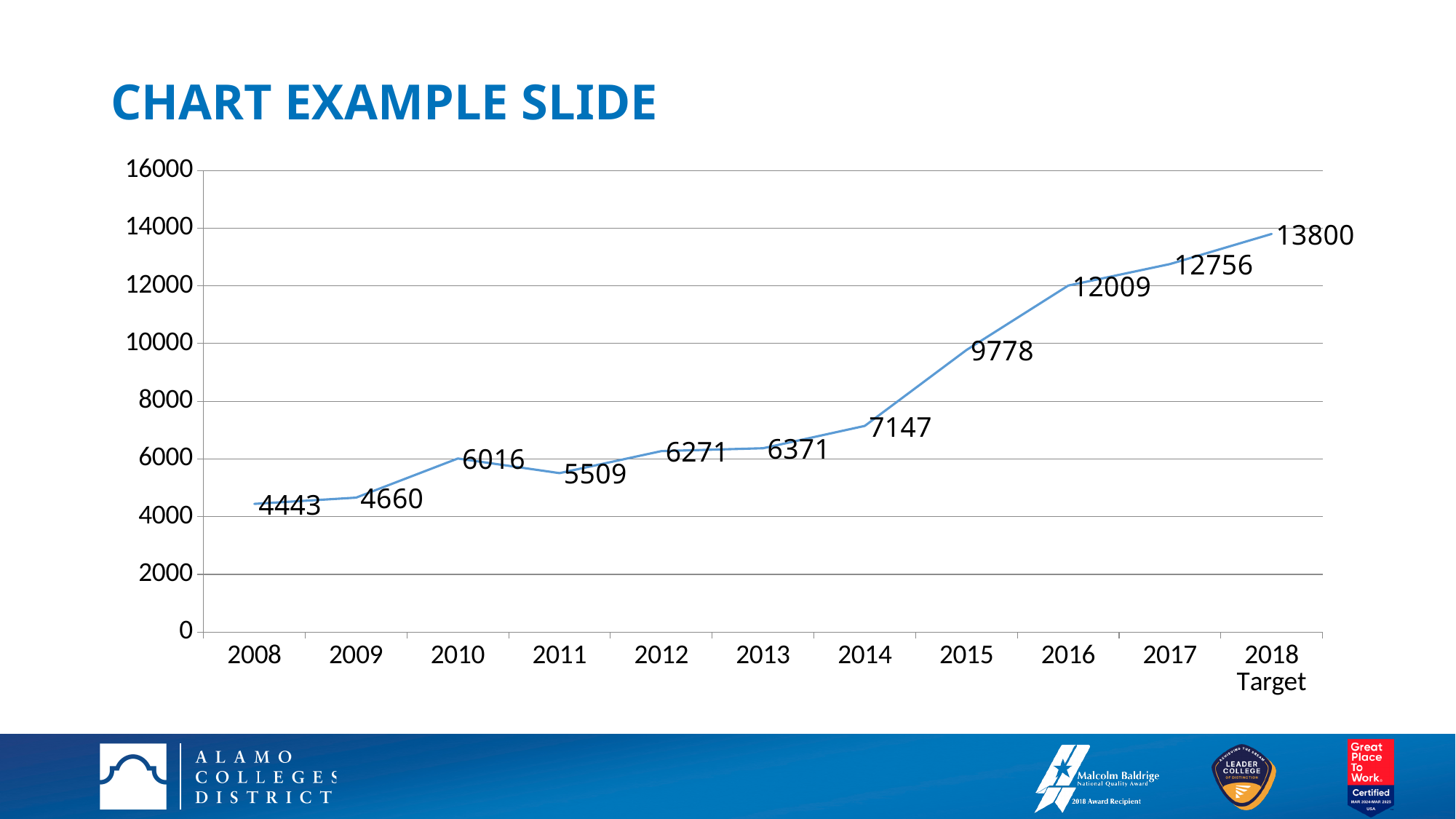
What kind of chart is shown on the slide? line chart What is the value for 2008? 4443 Which year has the lowest value? 2008 Is the value for 2014 greater or less than 8000? less What is the value for 2015? 9778 Which is larger, the value for 2010 or the value for 2011? 2010 How many data points are plotted on the chart? 11 Which category has the highest value? 2018 Target What is the value for 2018 Target? 13800 Do the values generally rise or fall from 2008 to 2018 Target? rise What is the title of the slide? CHART EXAMPLE SLIDE What is the difference between the values for 2016 and 2015? 2231